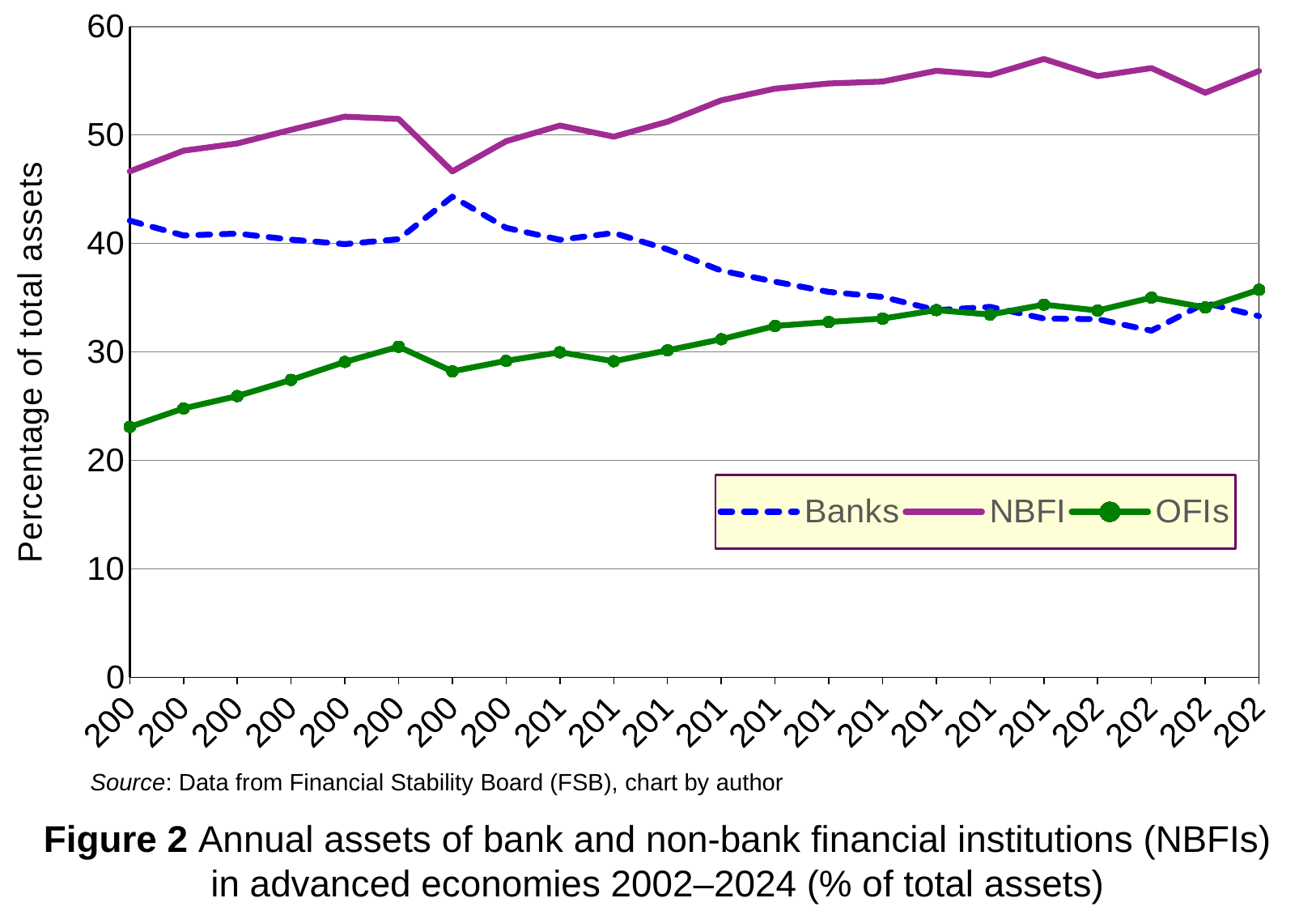
Is the value for NBFI at the last point on the x axis (2024) greater or less than 50? greater Is the value for Banks at the last point on the x axis (2024) greater or less than 40? less Is the value for OFIs at the first point on the x axis (2002) greater or less than 30? less What are the three series named in the legend? Banks, NBFI, OFIs What is the title of the y axis? Percentage of total assets Does the OFIs series generally rise or fall from left to right along the x axis? rise Which series has the highest value at the last point on the x axis (2024)? NBFI What kind of chart is shown on the slide? line chart At the first point on the x axis (2002), which is larger, the Banks value or the NBFI value? NBFI How many series does the legend list? 3 Does the Banks series generally rise or fall from left to right along the x axis? fall Does the NBFI series generally rise or fall from left to right along the x axis? rise